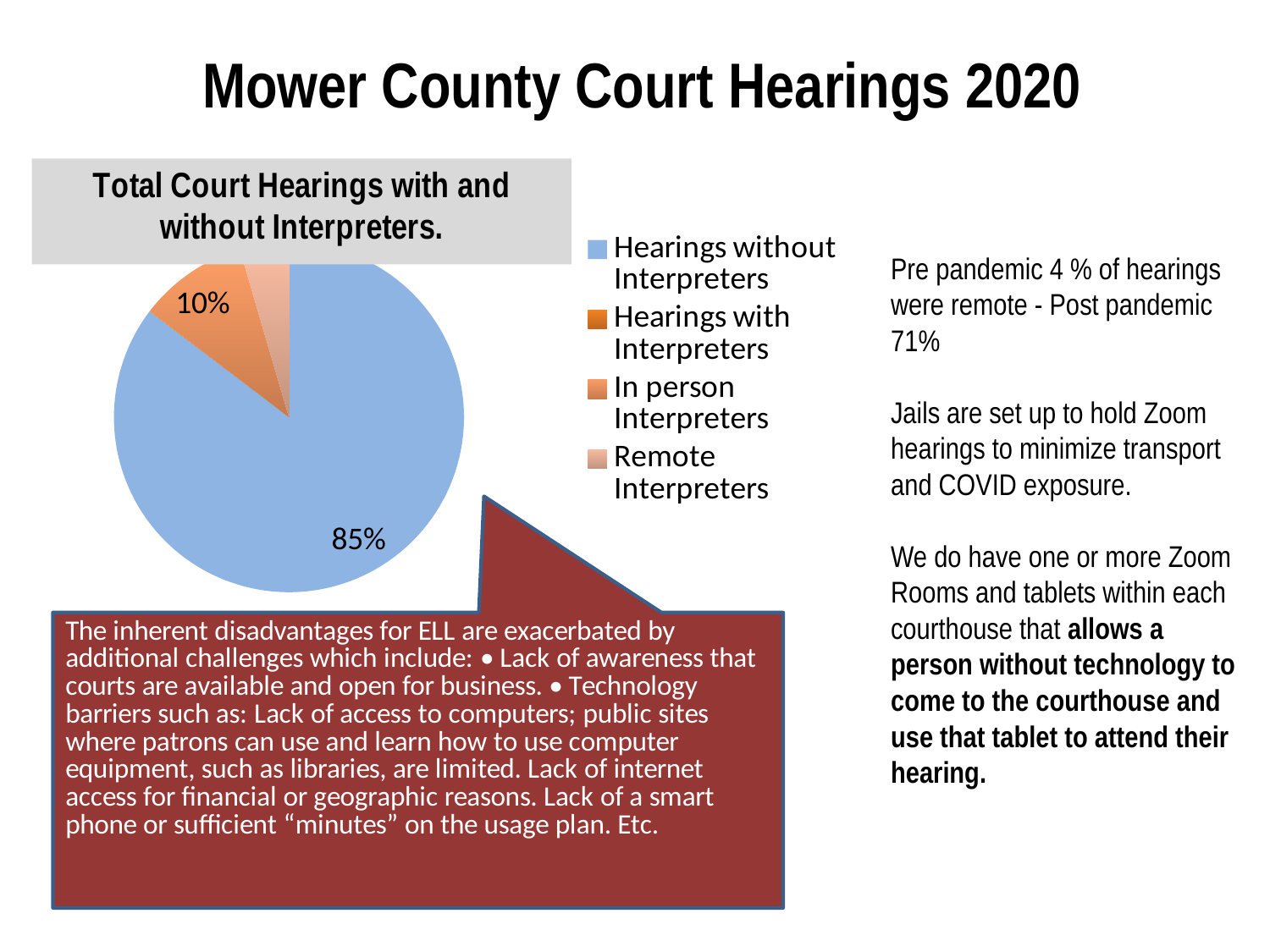
Which category has the largest slice of the pie? Hearings without Interpreters What is the value printed on the second-largest slice of the pie? 10% What kind of chart is shown on the slide? pie chart Which is larger: the slice for Hearings without Interpreters or the slice for Remote Interpreters? Hearings without Interpreters What colour is the slice for Hearings without Interpreters? blue What is the difference between the slice labeled 85% and the slice labeled 10%? 75% What is the title of the chart? Total Court Hearings with and without Interpreters. Is the share for Hearings without Interpreters greater or less than 50%? greater How many data labels are printed on the pie chart? 2 How many entries does the chart legend list? 4 What percentage of the pie is Hearings without Interpreters? 85%